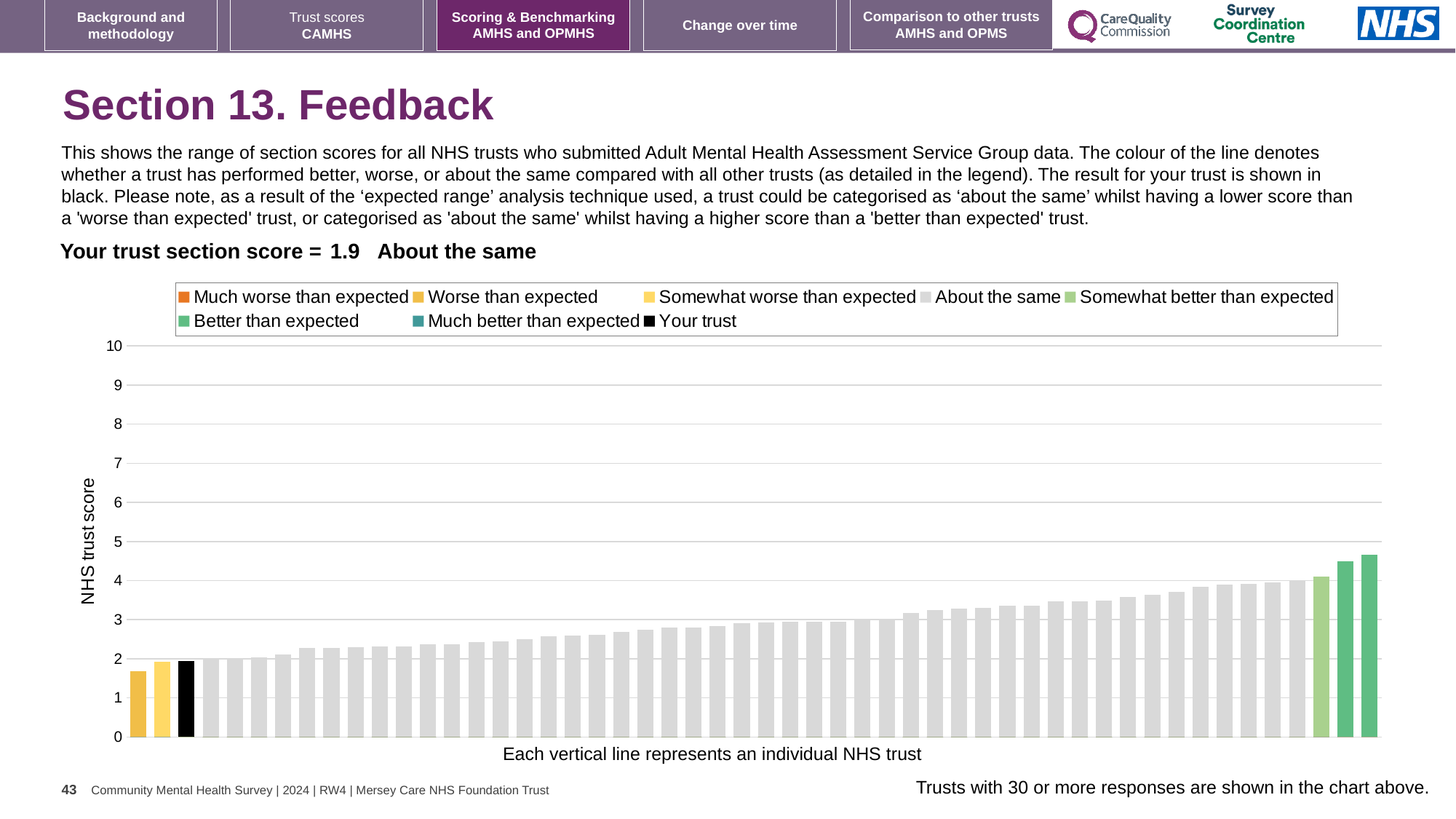
What is the label on the vertical axis of the chart? NHS trust score Do the bar values rise or fall from left to right across the chart? rise What colour is the bar representing your trust? black What is the section score for your trust shown on the slide? 1.9 What kind of chart is shown on the slide? bar chart Is the value of the tallest bar greater or less than 4? greater Which category is your trust's section score placed in? About the same Is the value of the shortest bar greater or less than 2? less Is the value of the tallest bar greater or less than 5? less How many entries does the chart legend list? 8 Which bar is taller, the leftmost bar or the rightmost bar? the rightmost bar